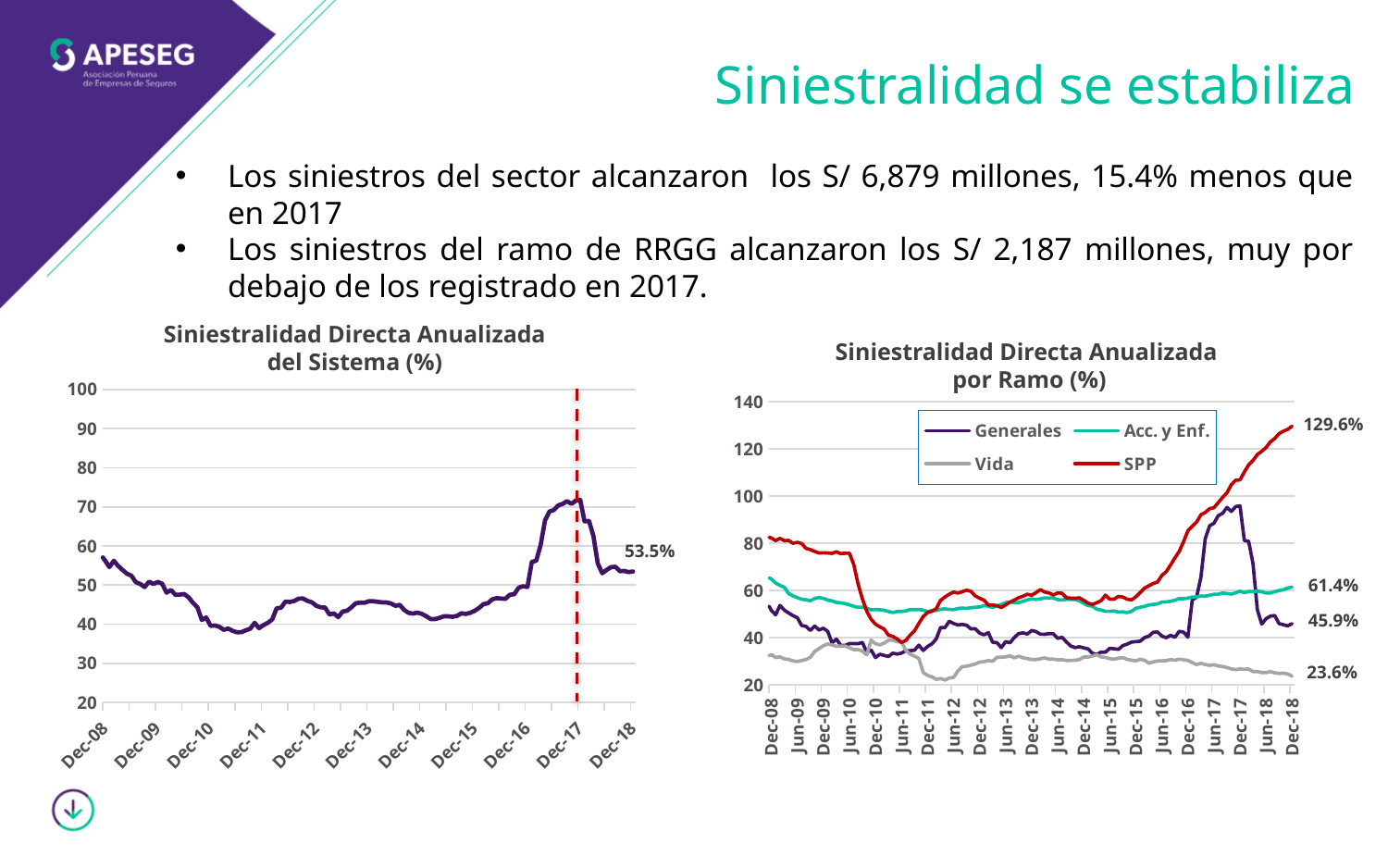
In the chart 'Siniestralidad Directa Anualizada del Sistema (%)', is the peak value around Dec-17 greater or less than 60? greater In the chart 'Siniestralidad Directa Anualizada por Ramo (%)', which series is drawn in red? SPP In the chart titled 'Siniestralidad Directa Anualizada del Sistema (%)', what is the value labelled at the end of the line (Dec-18)? 53.5% What kind of chart is 'Siniestralidad Directa Anualizada del Sistema (%)'? Line chart In the chart 'Siniestralidad Directa Anualizada por Ramo (%)', what is the final labelled value for SPP? 129.6% In the chart 'Siniestralidad Directa Anualizada del Sistema (%)', is the value at Dec-11 greater or less than 50? less In the chart 'Siniestralidad Directa Anualizada por Ramo (%)', which series has the highest value at Dec-18? SPP In the chart 'Siniestralidad Directa Anualizada por Ramo (%)', which series has the lowest value at Dec-18? Vida How many series does the legend list in the chart 'Siniestralidad Directa Anualizada por Ramo (%)'? 4 In the chart 'Siniestralidad Directa Anualizada por Ramo (%)', what is the final labelled value for Vida? 23.6% In the chart 'Siniestralidad Directa Anualizada por Ramo (%)', what is the difference between the final values of SPP (129.6%) and Generales (45.9%)? 83.7% In the chart 'Siniestralidad Directa Anualizada por Ramo (%)', what is the final labelled value for Acc. y Enf.? 61.4%